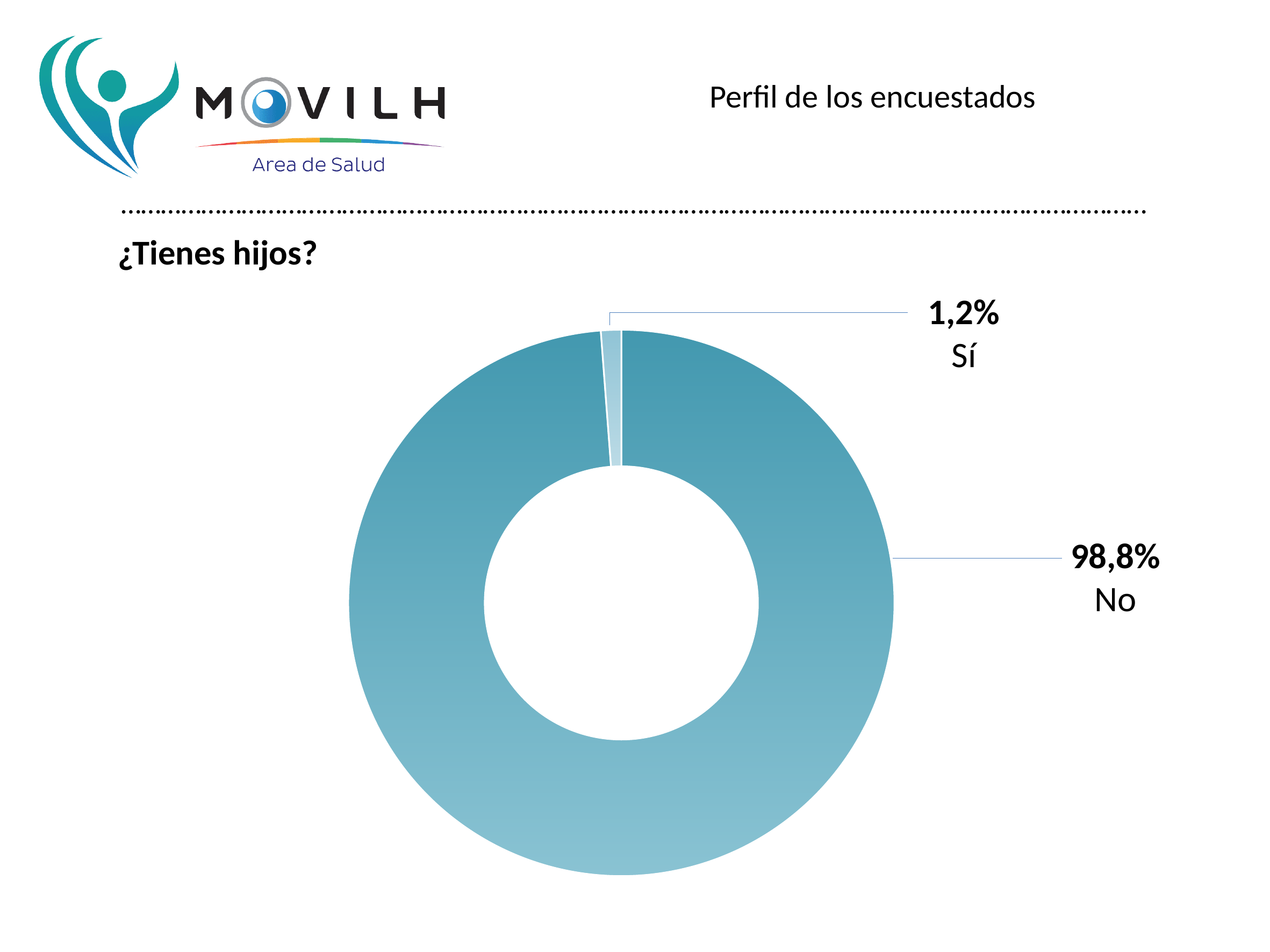
Which category has the smallest share in the chart? Sí Which is larger, the share for "Sí" or the share for "No"? No What question does the chart on the slide answer? ¿Tienes hijos? What is the total of the two shares shown in the chart? 100% How many categories are shown in the chart? 2 What kind of chart is shown on the slide? Pie chart (donut) What is the difference in percentage points between the "No" and "Sí" shares? 97,6 Which category has the largest share in the chart? No What is the heading at the top of the slide? Perfil de los encuestados What percentage of respondents answered "No" to "¿Tienes hijos?"? 98,8% What percentage of respondents answered "Sí" to "¿Tienes hijos?"? 1,2%